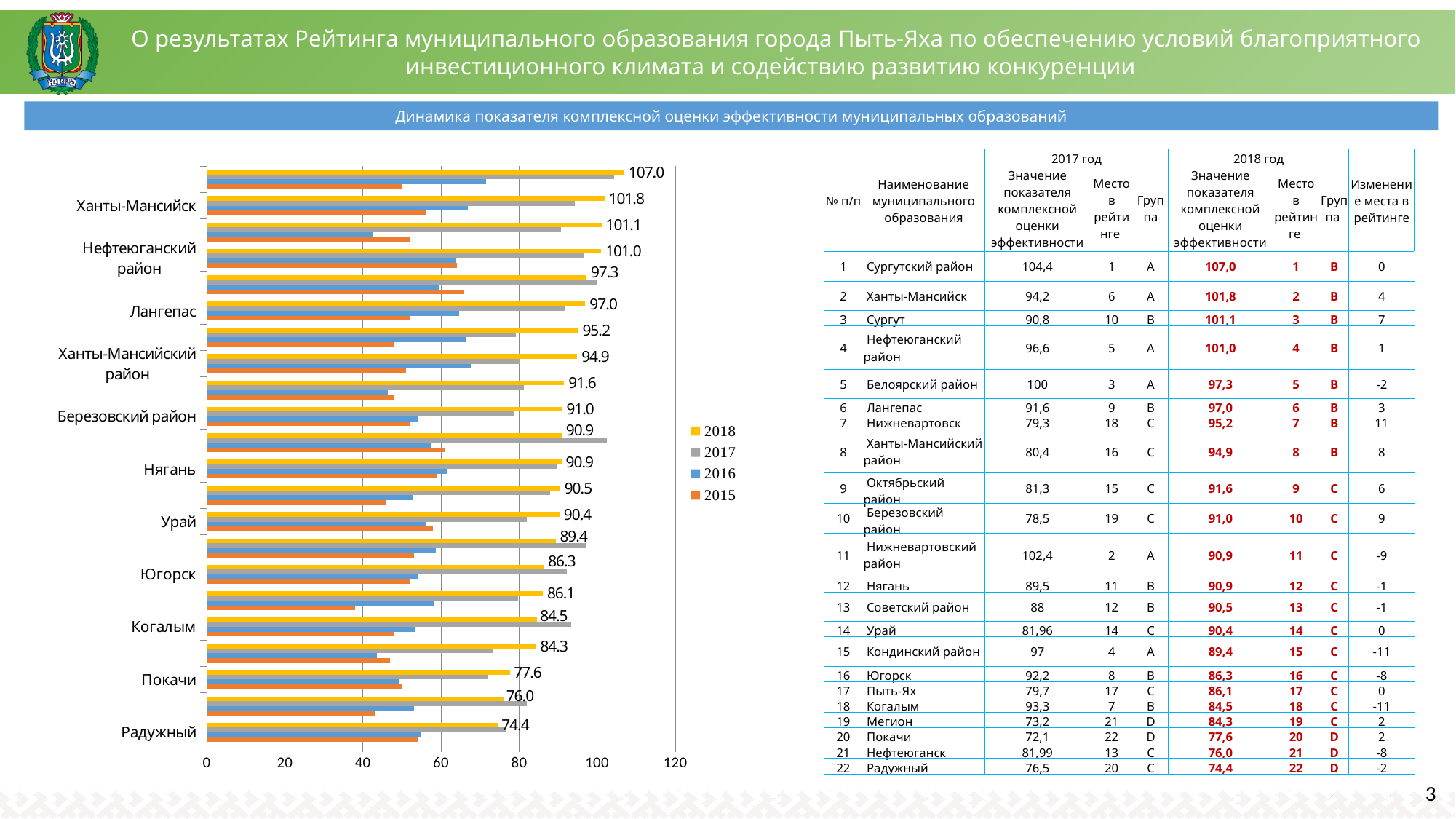
Which has the larger 2018 value in the chart, Югорск or Когалым? Югорск What is the difference between the 2018 values for Ханты-Мансийск and Радужный? 27.4 Which series in the chart has its values printed as data labels? 2018 What is the 2018 value for Радужный in the chart? 74.4 What is the 2018 value for Лангепас in the chart? 97.0 Is the 2017 value for Ханты-Мансийск greater or less than 80? greater What is the 2018 value for Ханты-Мансийск in the chart? 101.8 What is the highest 2018 value labelled in the chart? 107.0 What kind of chart is shown on the slide? bar chart Is the 2015 value for Радужный greater or less than 60? less How many series does the chart legend list? 4 Which labelled category has the lowest 2018 value in the chart? Радужный